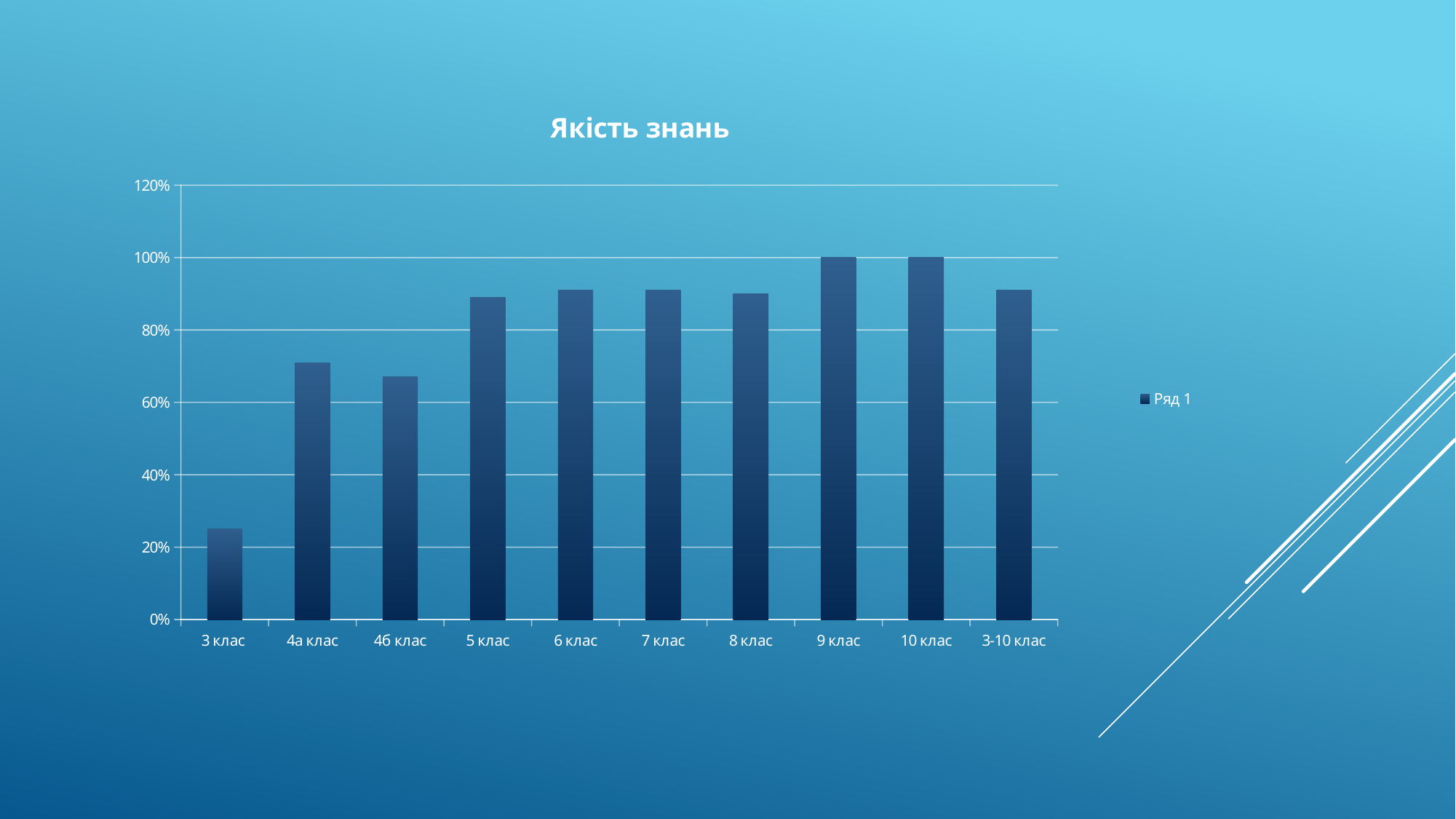
How many series does the legend list? 1 How many categories are shown on the x axis of the chart? 10 What is the name of the series shown in the legend? Ряд 1 Which is larger, the value for 4б клас or the value for 5 клас? 5 клас What type of chart is shown on the slide? Bar chart Which category has the lowest value? 3 клас Is the value for 3 клас greater or less than 40%? less Is the value for 4а клас greater or less than 60%? greater Is the value for 4б клас greater or less than 80%? less What is the value for 9 клас? 100% What is the title of the chart? Якість знань